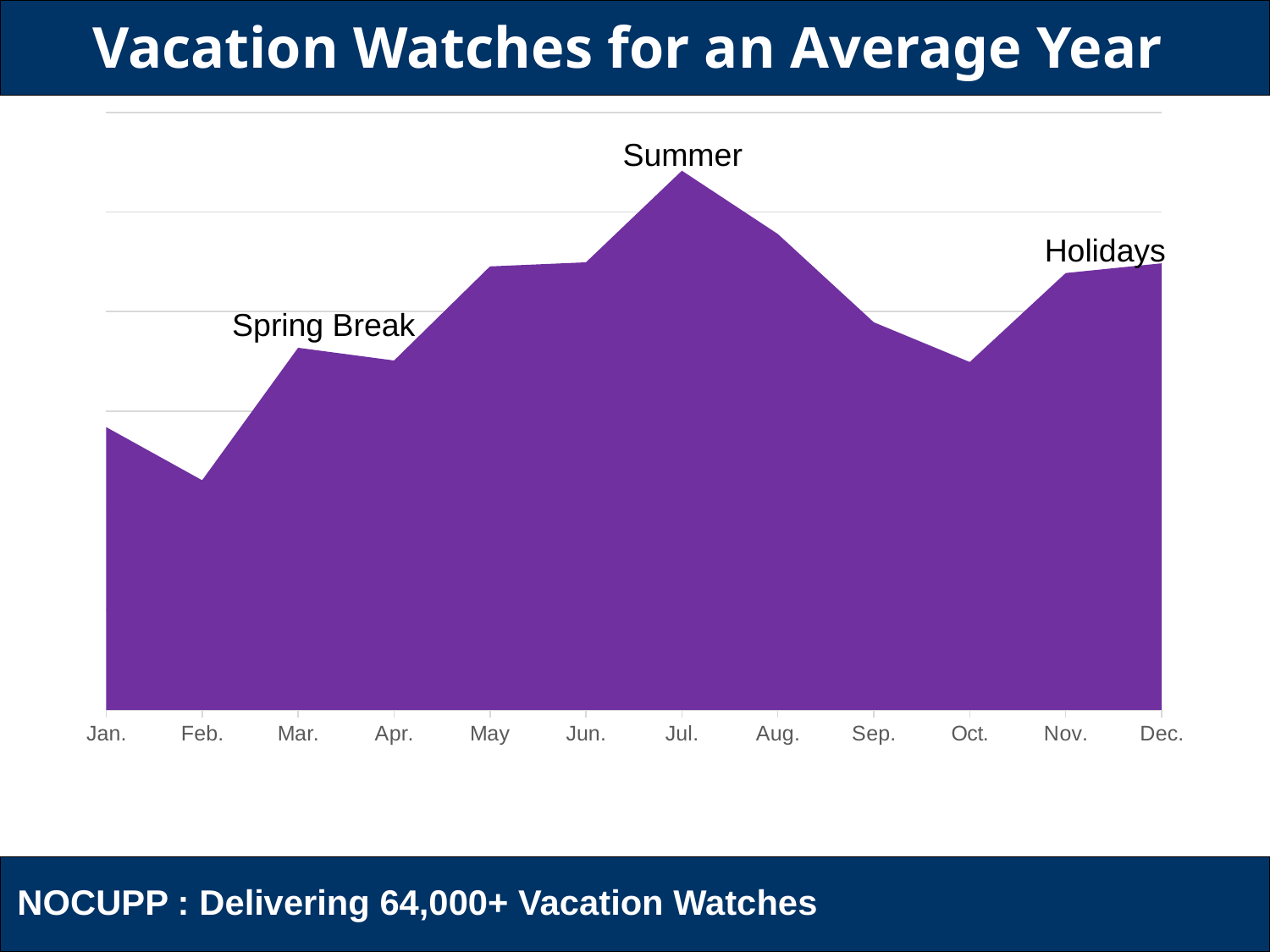
What is the title of the chart? Vacation Watches for an Average Year Which month has the lowest value in the chart? Feb. Which month is higher in the chart, Dec. or Jan.? Dec. Which month is higher in the chart, Sep. or Oct.? Sep. What kind of chart is shown on the slide? Area chart Which month has the highest value in the chart? Jul. Which label is placed at the peak of the chart in July? Summer Which month is higher in the chart, Jul. or Feb.? Jul. Do the values rise or fall from Jul. to Oct.? Fall Do the values rise or fall from Jan. to Feb.? Fall How many months are shown along the x axis of the chart? 12 Do the values rise or fall from Oct. to Dec.? Rise